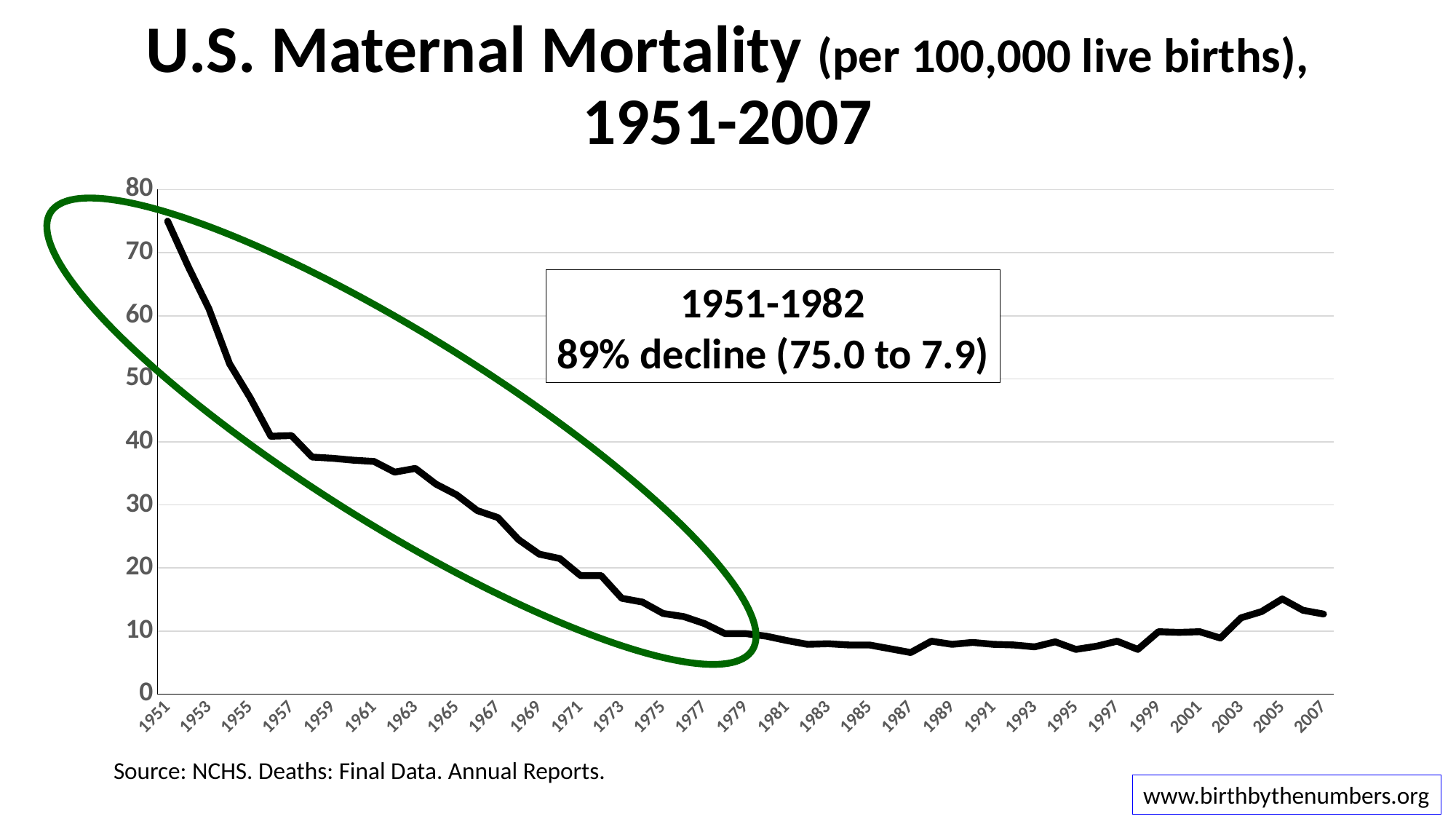
Is the value for 1965 greater or less than 30? greater Does the maternal mortality rate rise or fall from 1951 to 1982? fall What was the U.S. maternal mortality rate per 100,000 live births in 1951? 75.0 By how much did the maternal mortality rate fall between 1951 and 1982, using the values printed on the slide? 67.1 What kind of chart is shown on the slide? line chart In which year is the maternal mortality rate highest? 1951 What percentage decline in maternal mortality does the slide report for 1951-1982? 89% Which year has the higher maternal mortality rate, 1953 or 1963? 1953 What was the U.S. maternal mortality rate per 100,000 live births in 1982? 7.9 Is the value for 2005 greater or less than 10? greater Is the value for 1959 greater or less than 40? less